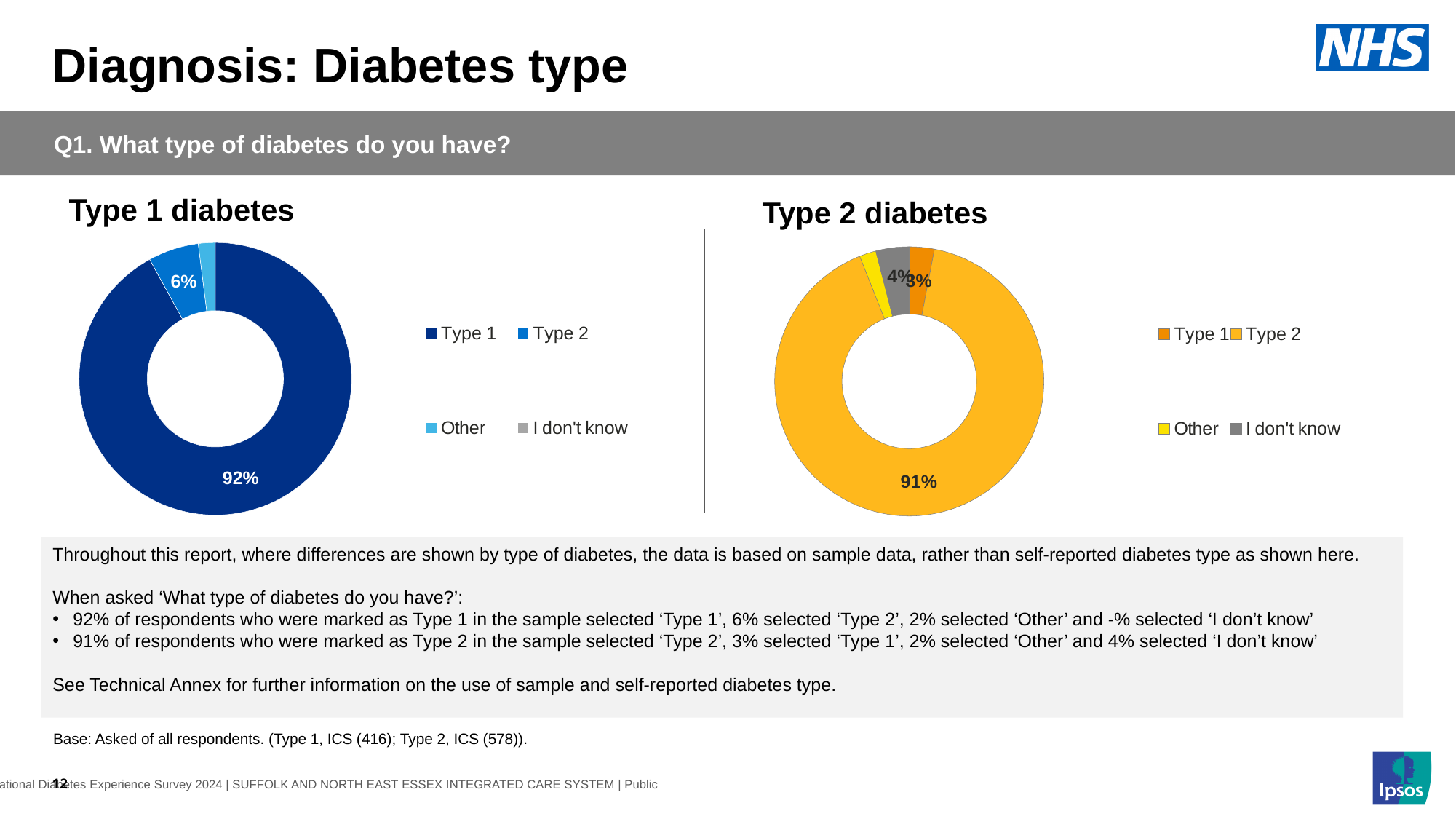
In the 'Type 2 diabetes' chart, what percentage of respondents selected 'Type 2'? 91% In the 'Type 2 diabetes' chart, what percentage of respondents selected 'Type 1'? 3% In the 'Type 1 diabetes' chart, what percentage of respondents selected 'Type 2'? 6% What kind of chart is used for 'Type 1 diabetes'? Donut (pie) chart How many categories does the legend of the 'Type 2 diabetes' chart list? 4 In the 'Type 1 diabetes' chart, what percentage of respondents selected 'Type 1'? 92% In the 'Type 2 diabetes' chart, what colour is the 'Other' segment? Yellow In the 'Type 2 diabetes' chart, which category has the largest share? Type 2 In the 'Type 2 diabetes' chart, what percentage of respondents selected 'I don't know'? 4% In the 'Type 1 diabetes' chart, what is the difference between the 'Type 1' share and the 'Type 2' share? 86 percentage points In the 'Type 1 diabetes' chart, which category has the largest share? Type 1 Which is larger: the 'Type 1' share in the 'Type 1 diabetes' chart or the 'Type 2' share in the 'Type 2 diabetes' chart? The 'Type 1' share in the 'Type 1 diabetes' chart (92%)